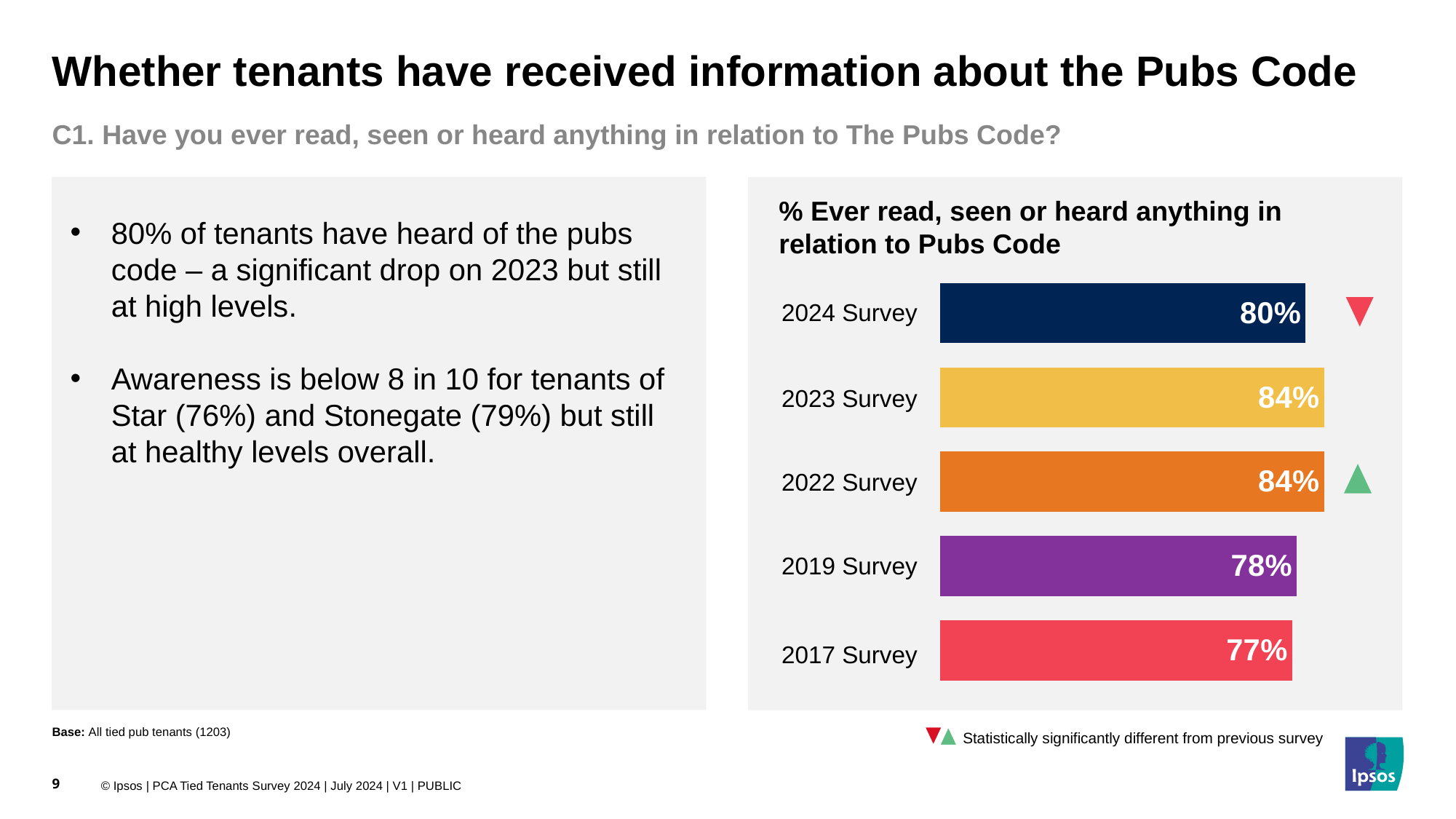
Do the values for the 2022 Survey and the 2023 Survey differ? No, both are 84% Which is larger, the value for the 2022 Survey or the 2019 Survey? 2022 Survey What is the value for the 2019 Survey? 78% What is the difference between the 2023 Survey and the 2024 Survey values? 4% What is the title of the chart? % Ever read, seen or heard anything in relation to Pubs Code What is the difference between the 2019 Survey and the 2017 Survey values? 1% Which survey year has the lowest value? 2017 Survey How many survey years are shown in the chart? 5 What kind of chart is shown on the slide? Bar chart What is the value for the 2024 Survey? 80% What is the value for the 2017 Survey? 77% What colour is the bar for the 2019 Survey? Purple